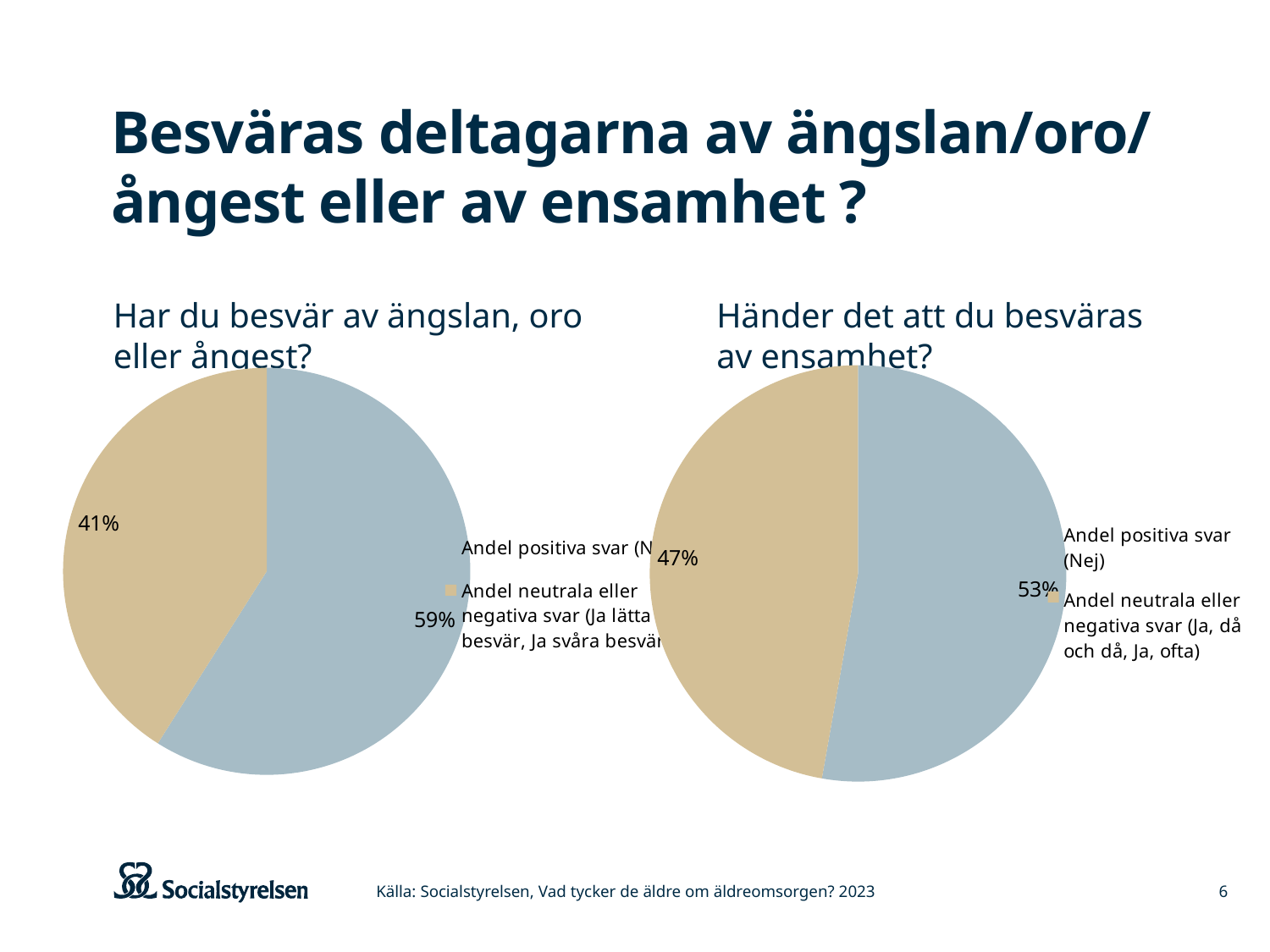
How many slices does the chart "Händer det att du besväras av ensamhet?" have? 2 In the chart "Händer det att du besväras av ensamhet?", which slice is the smallest? Andel neutrala eller negativa svar In the chart "Har du besvär av ängslan, oro eller ångest?", what share is "Andel positiva svar (Nej)"? 59% How many pie charts are shown on the slide? 2 What kind of chart is used for "Har du besvär av ängslan, oro eller ångest?"? Pie chart In the chart "Händer det att du besväras av ensamhet?", what is the difference between the positive and the neutral/negative shares? 6 percentage points In the chart "Händer det att du besväras av ensamhet?", what share is "Andel positiva svar (Nej)"? 53% Which chart has the larger share of "Andel positiva svar (Nej)": the left one about ängslan/oro/ångest or the right one about ensamhet? The left one (ängslan, oro eller ångest) In the chart "Händer det att du besväras av ensamhet?", what share is "Andel neutrala eller negativa svar"? 47% In the chart "Har du besvär av ängslan, oro eller ångest?", what is the difference between the positive and the neutral/negative shares? 18 percentage points In the chart "Har du besvär av ängslan, oro eller ångest?", which slice is the largest? Andel positiva svar (Nej)